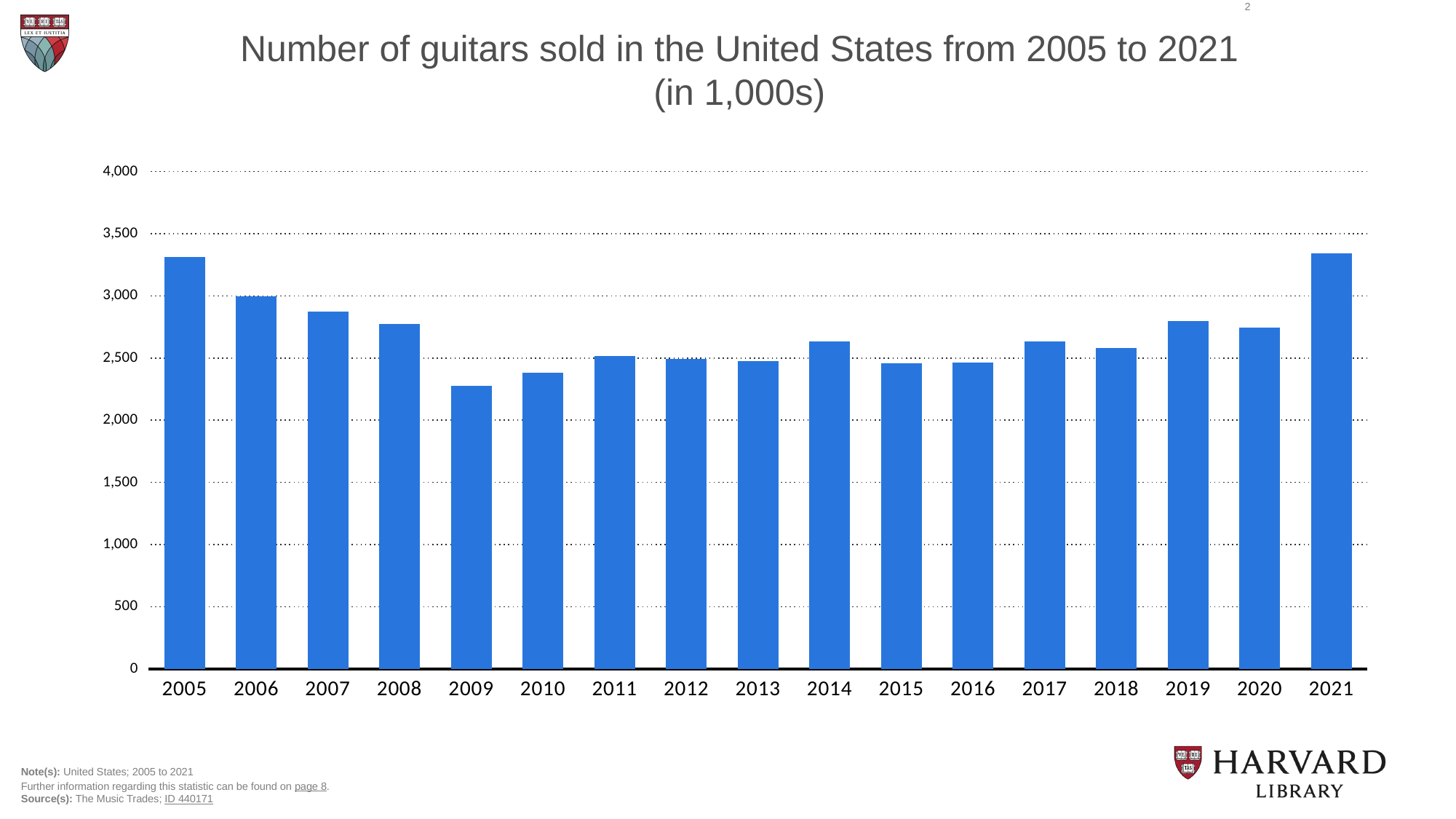
How many years are shown on the x axis of the chart? 17 Is the value for 2014 greater or less than 2,500? greater What kind of chart is shown on the slide? bar chart Is the value for 2007 greater or less than 3,000? less What is the title of the chart? Number of guitars sold in the United States from 2005 to 2021 (in 1,000s) Which year has the lowest number of guitars sold? 2009 Is the value for 2009 greater or less than 2,500? less Do the values rise or fall from 2005 to 2009? fall Which year has the larger value, 2005 or 2006? 2005 Which year has the larger value, 2009 or 2010? 2010